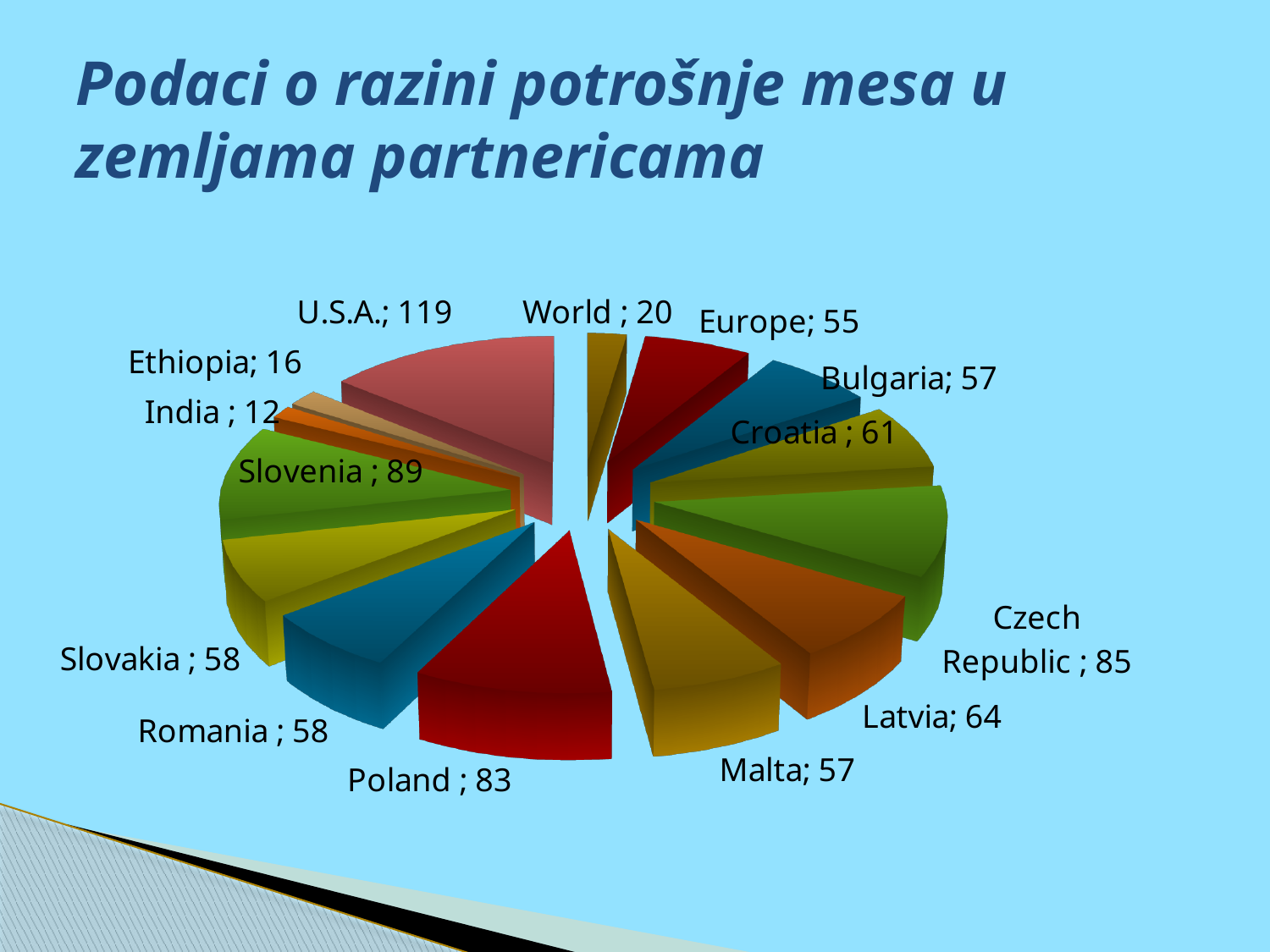
What is the title of the slide containing the pie chart? Podaci o razini potrošnje mesa u zemljama partnericama Which category has the highest value in the pie chart? U.S.A. Which category has the lowest value in the pie chart? India How many categories (slices) does the pie chart have? 14 What kind of chart is shown on the slide? pie chart What is the value for Czech Republic in the pie chart? 85 What is the value for Slovenia in the pie chart? 89 Which has a larger value, Croatia or Bulgaria? Croatia What is the difference between the values for U.S.A. and Czech Republic? 34 What is the value for World in the pie chart? 20 What is the difference between the values for Slovenia and Poland? 6 What is the value for Latvia in the pie chart? 64